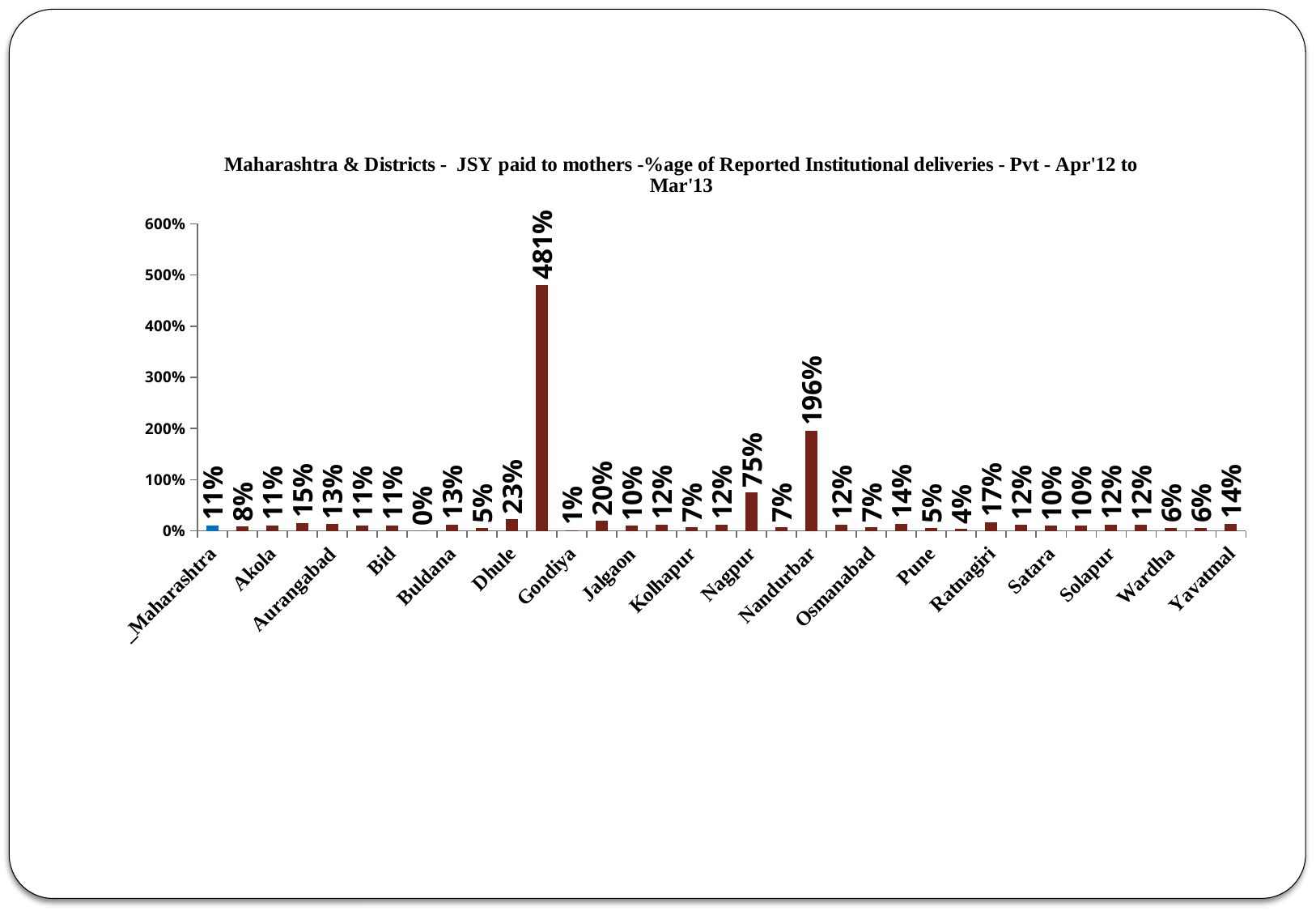
What is the value for Nandurbar? 196% What is the value for _Maharashtra? 11% Is the value for Nandurbar greater or less than 100%? greater What is the value for Pune? 5% What colour is the bar for _Maharashtra? blue What is the difference between the values for Nandurbar and Nagpur? 121% What is the highest value shown on the chart? 481% What is the value for Dhule? 23% Which has a larger value, Ratnagiri or Yavatmal? Ratnagiri What is the value for Gondiya? 1% What is the value for Nagpur? 75% What kind of chart is shown on the slide? bar chart